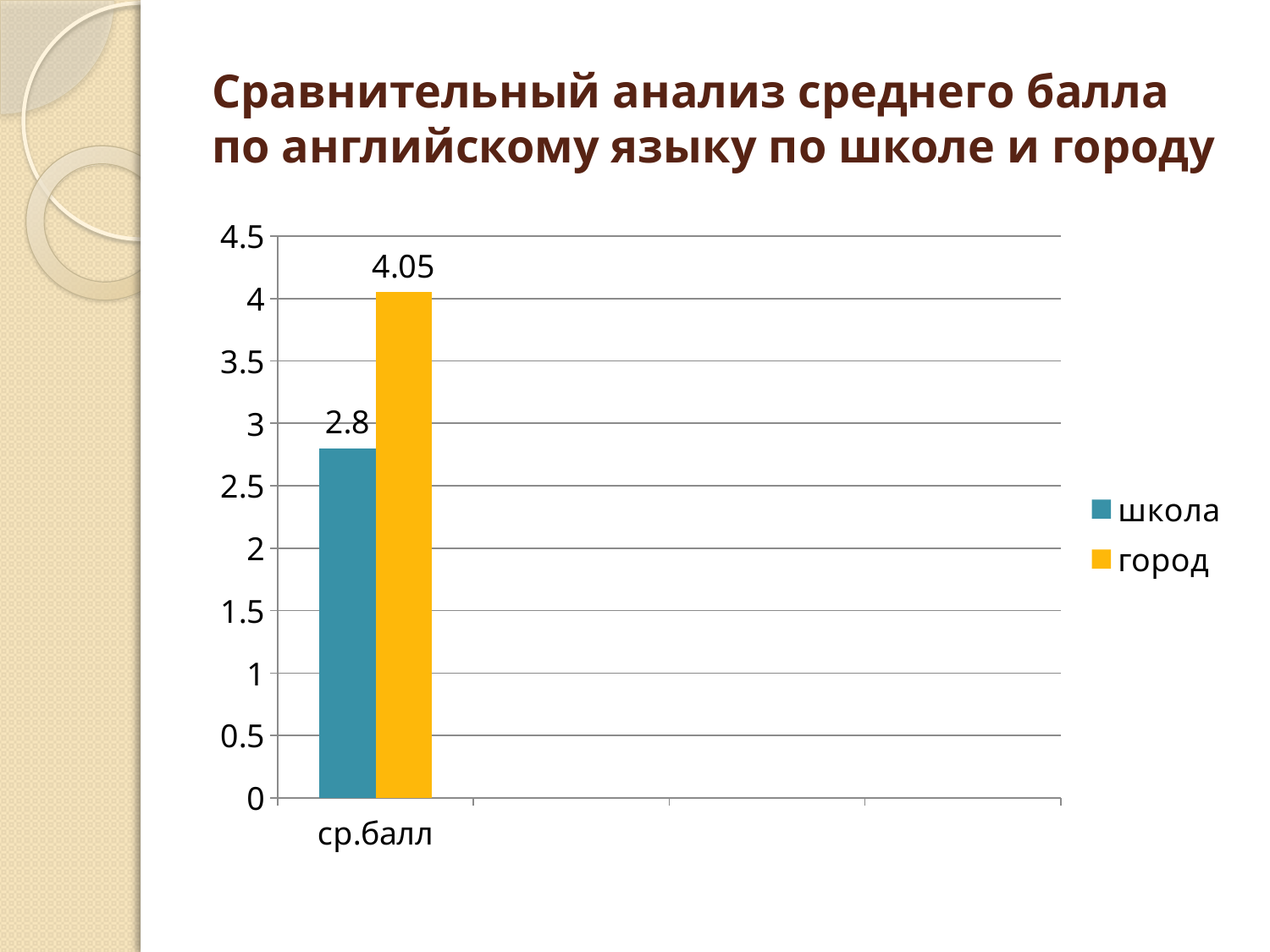
Which series has the higher value, школа or город? город What colour is the bar for город? yellow What kind of chart is shown on the slide? bar chart How many series does the legend list? 2 Is the value for школа greater or less than 3? less What is the difference between the город and школа values? 1.25 What is the label of the category on the x axis? ср.балл What is the value for школа in the ср.балл category? 2.8 Is the value for город greater or less than 4? greater What is the value for город in the ср.балл category? 4.05 How many categories are shown on the x axis? 1 Which series has the lowest value? школа